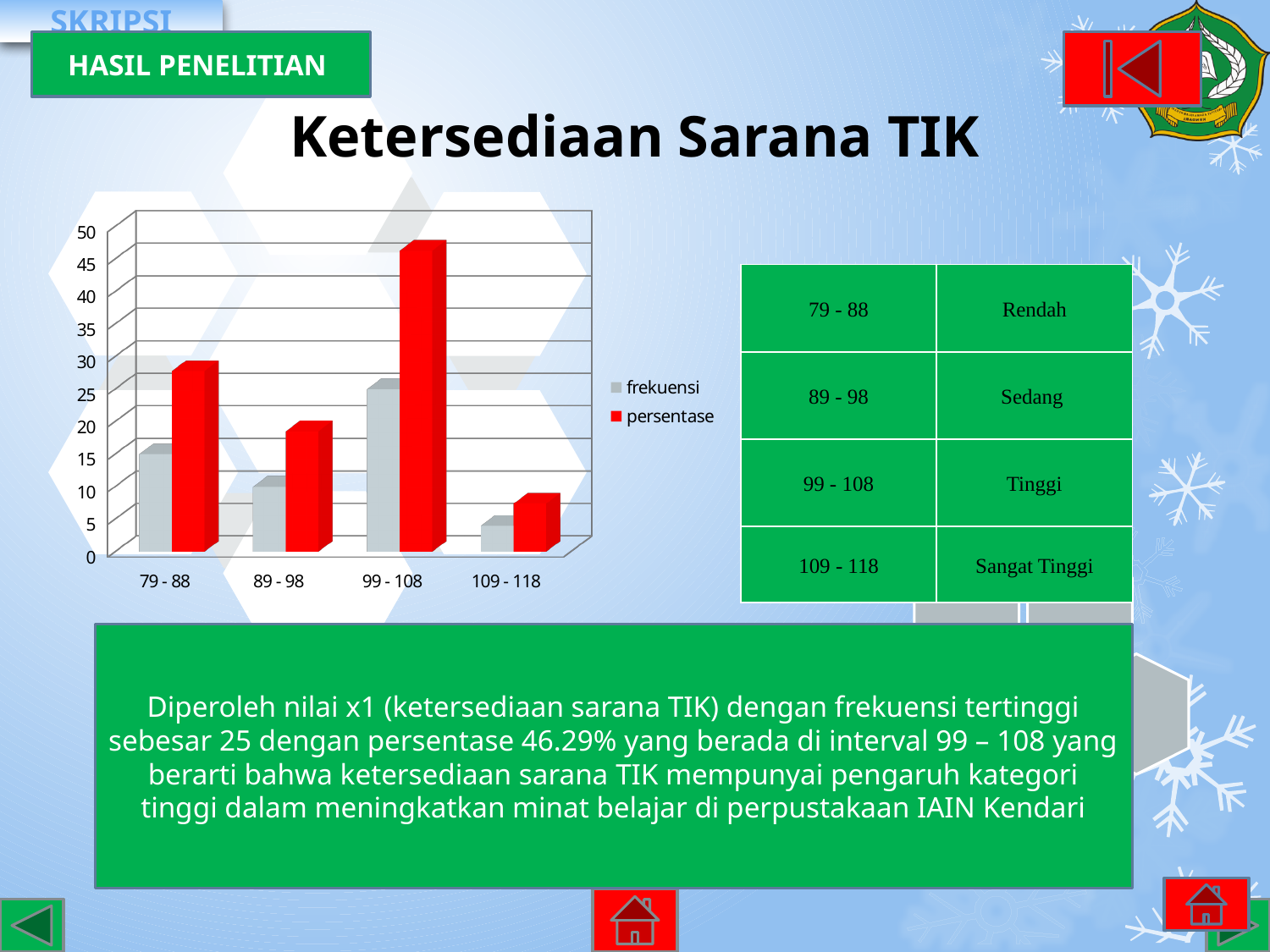
Which category has the lowest frekuensi value? 109 - 118 What kind of chart is shown on the slide? bar chart How many series does the chart legend list? 2 What colour are the persentase bars in the chart? red Is the frekuensi value for 89 - 98 greater or less than 15? less Is the persentase value for 99 - 108 greater or less than 40? greater Is the persentase value for 109 - 118 greater or less than 10? less Which category has the highest persentase value? 99 - 108 Which category has the lowest persentase value? 109 - 118 How many categories are shown on the x axis of the chart? 4 Which is larger, the frekuensi value for 79 - 88 or for 89 - 98? 79 - 88